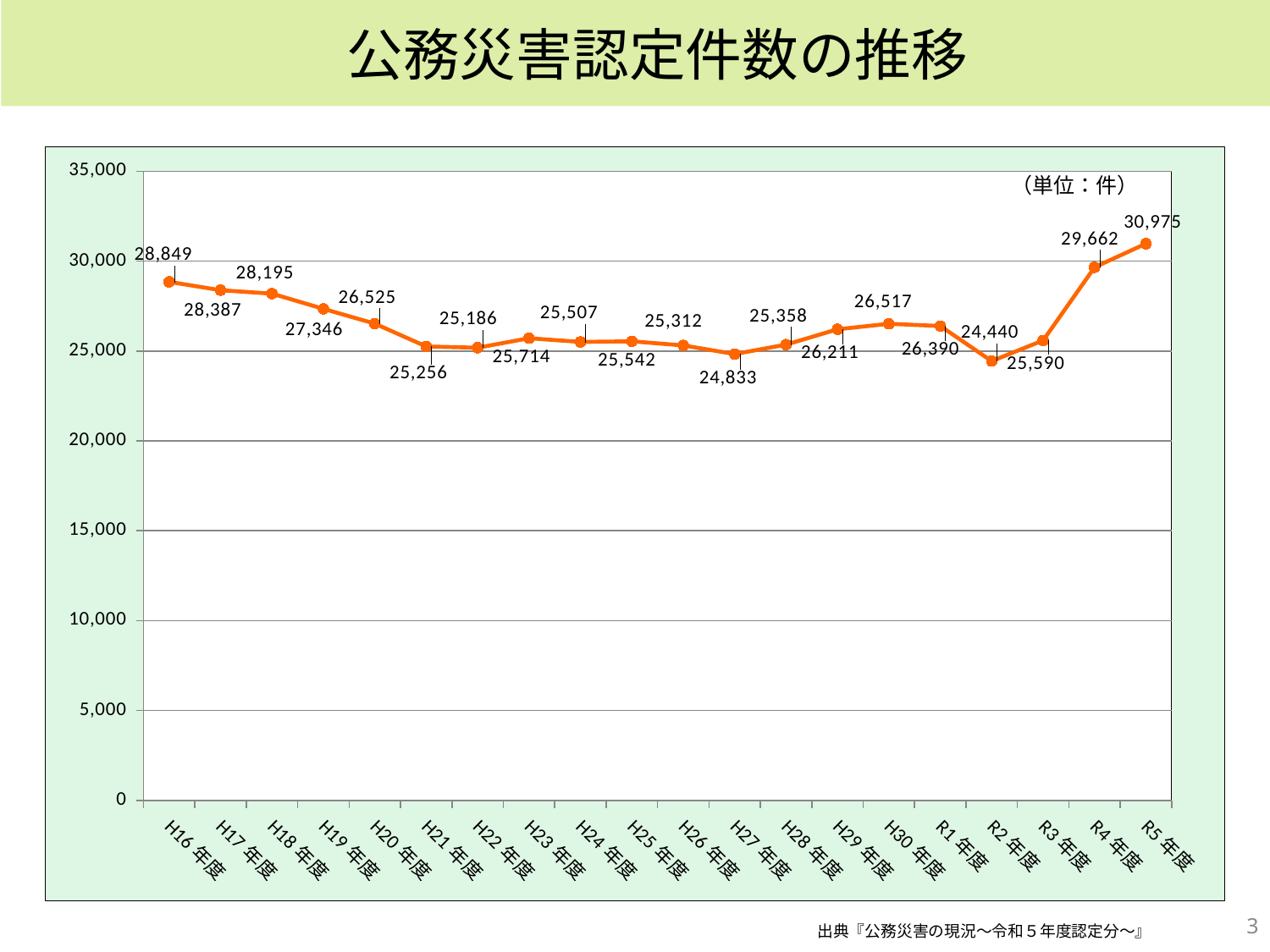
Is the value for H19年度 greater or less than 25,000? greater What is the value for H27年度? 24,833 Do the values rise or fall from R2年度 to R5年度? rise What is the difference between the values for R5年度 and R4年度? 1,313 What kind of chart is shown? line chart How many years are plotted on the chart? 20 What is the value for R2年度? 24,440 Which is larger, the value for H20年度 or H21年度? H20年度 What is the value for R4年度? 29,662 Which year has the lowest value? R2年度 Which year has the highest value? R5年度 What is the value for H16年度? 28,849